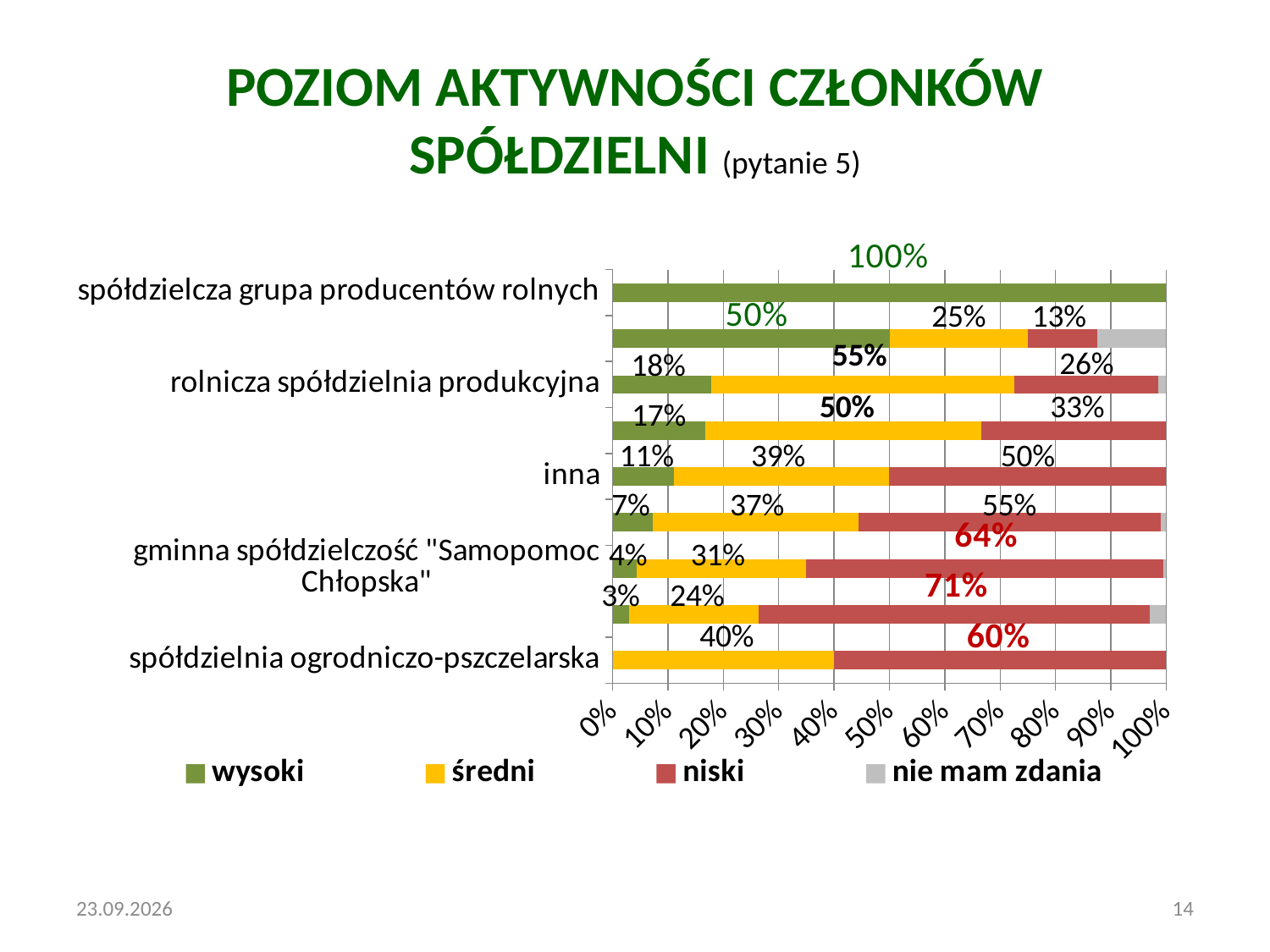
What is the difference between the 'niski' value for 'gminna spółdzielczość "Samopomoc Chłopska"' and the 'niski' value for 'inna'? 14 percentage points Is the 'niski' value for 'spółdzielnia ogrodniczo-pszczelarska' greater or less than 50%? greater What is the 'niski' value for 'inna'? 50% What is the 'wysoki' value for 'inna'? 11% Which has a larger 'niski' value: 'gminna spółdzielczość "Samopomoc Chłopska"' or 'inna'? gminna spółdzielczość "Samopomoc Chłopska" What is the 'średni' value for 'rolnicza spółdzielnia produkcyjna'? 55% What is the 'średni' value for 'spółdzielnia ogrodniczo-pszczelarska'? 40% What are the legend entries of the chart? wysoki, średni, niski, nie mam zdania How many series does the legend list? 4 What is the 'wysoki' value for 'spółdzielcza grupa producentów rolnych'? 100% What is the 'niski' value for 'gminna spółdzielczość "Samopomoc Chłopska"'? 64% What kind of chart is shown on the slide? Stacked bar chart